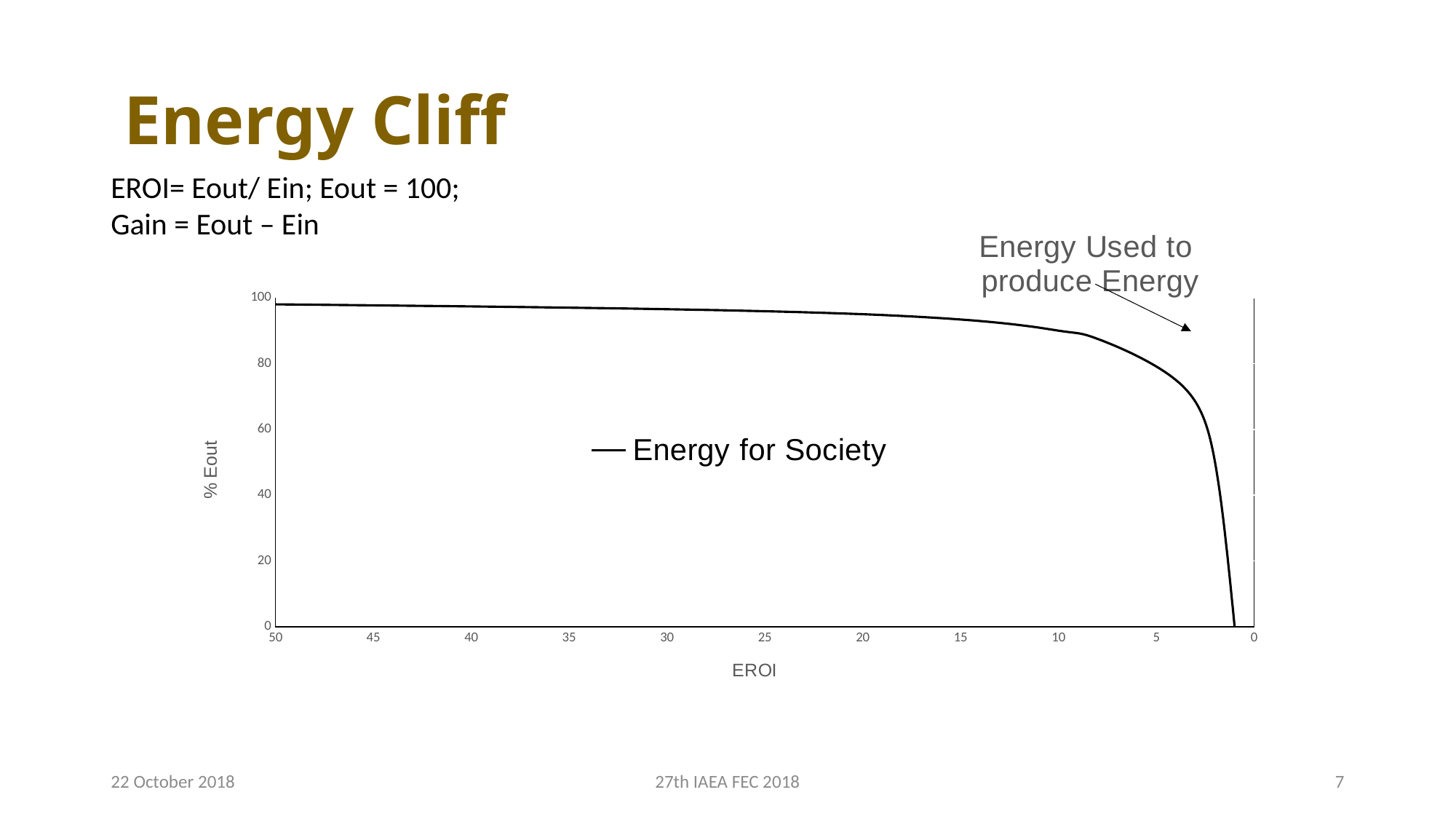
What is the label of the chart's x axis? EROI What is the name of the series shown in the chart's legend? Energy for Society Is the value of the Energy for Society curve at EROI 50 greater or less than 90? greater Is the value of the Energy for Society curve at EROI 1 greater or less than 20? less Is the value of the Energy for Society curve at EROI 25 greater or less than 80? greater How many series does the chart's legend list? 1 What kind of chart is shown on the slide? line chart Moving from left to right along the x axis (from EROI 50 toward 0), does the Energy for Society curve rise or fall? fall Which is larger, the value of the Energy for Society curve at EROI 30 or at EROI 3? EROI 30